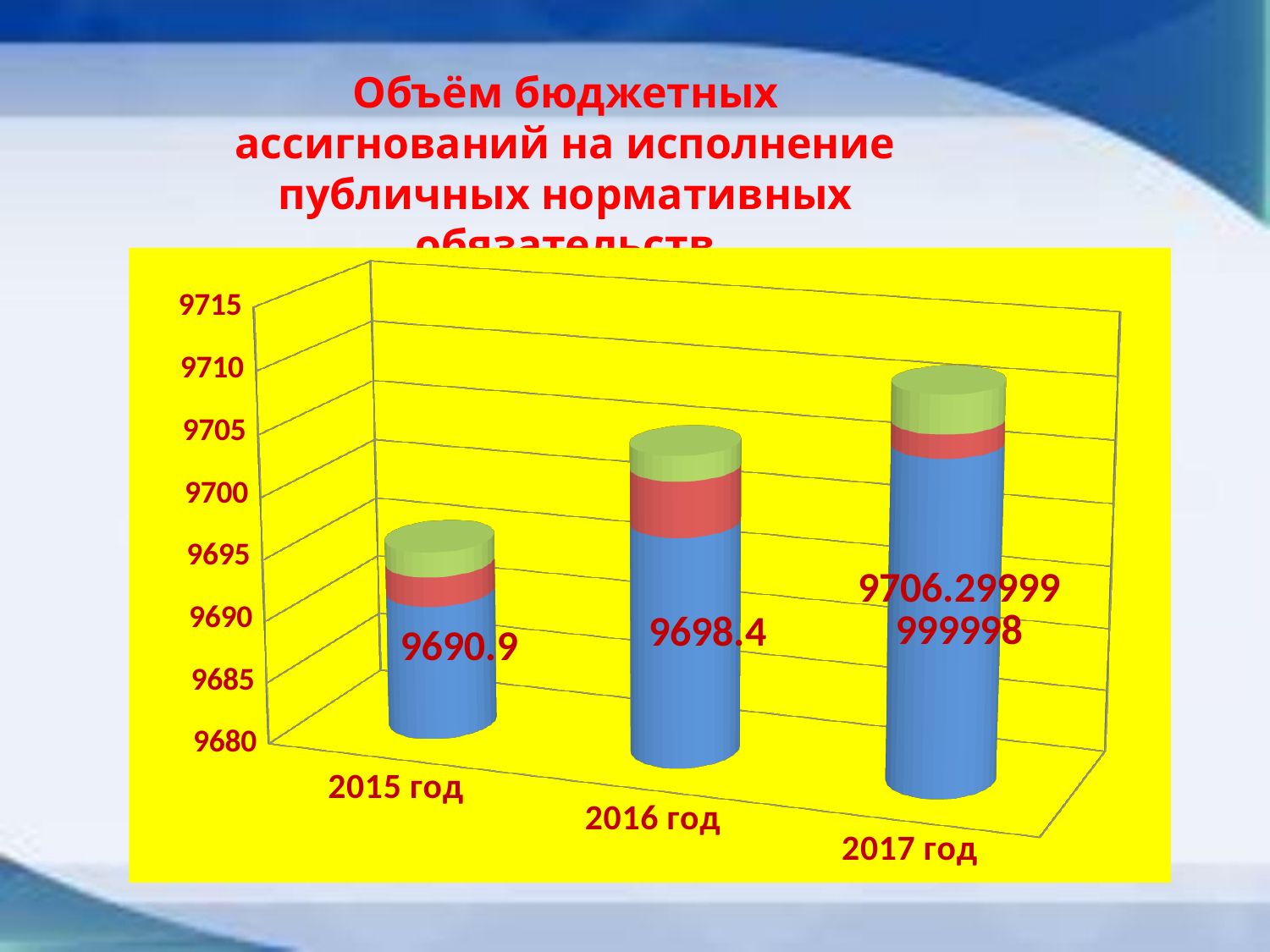
Which is larger, the value for 2016 год or the value for 2015 год? 2016 год How many years are shown on the chart? 3 Do the values rise or fall from 2015 год to 2017 год? rise What is the value for 2016 год? 9698.4 Which year has the lowest value? 2015 год What is the value for 2015 год? 9690.9 Is the value for 2015 год greater or less than 9700? less Which year has the highest value? 2017 год What kind of chart is shown on the slide? bar chart What is the lowest value shown on the vertical axis? 9680 What is the difference between the values for 2016 год and 2015 год? 7.5 What is the value shown for 2017 год? 9706.29999999998